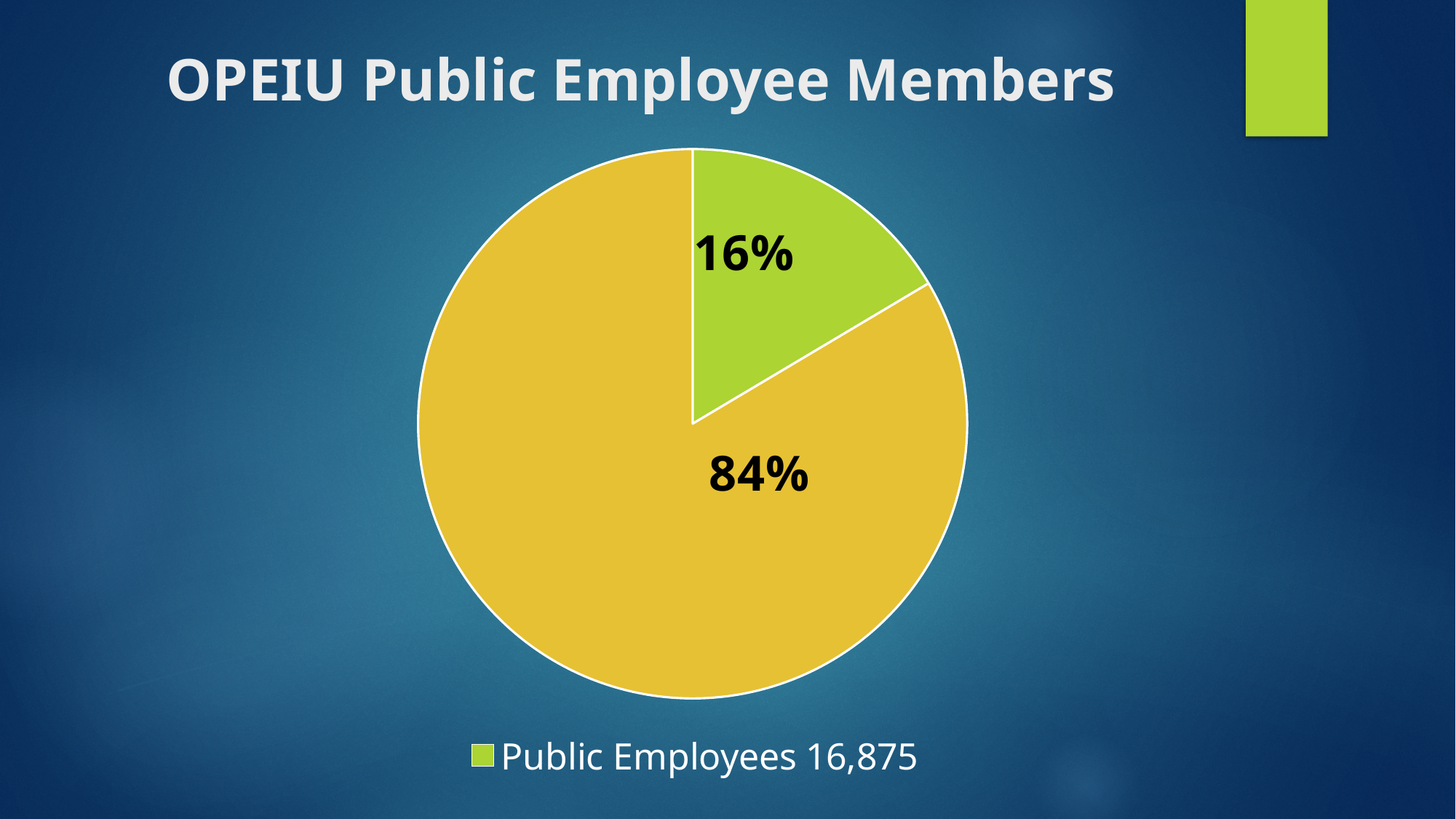
What is the difference in percentage points between the 84% slice and the 16% slice? 68 percentage points How many entries does the legend list? 1 What kind of chart is shown on the slide? pie chart Which is larger, the green slice or the yellow slice? the yellow slice What share of the pie does the yellow slice represent? 84% Which slice is the largest in the pie chart? the yellow slice (84%) What share of the pie does the Public Employees slice represent? 16% Which slice is the smallest in the pie chart? Public Employees (16%) How many slices does the pie chart have? 2 What is the title of the slide? OPEIU Public Employee Members What text does the legend entry show? Public Employees 16,875 Is the share for Public Employees greater or less than 50%? less